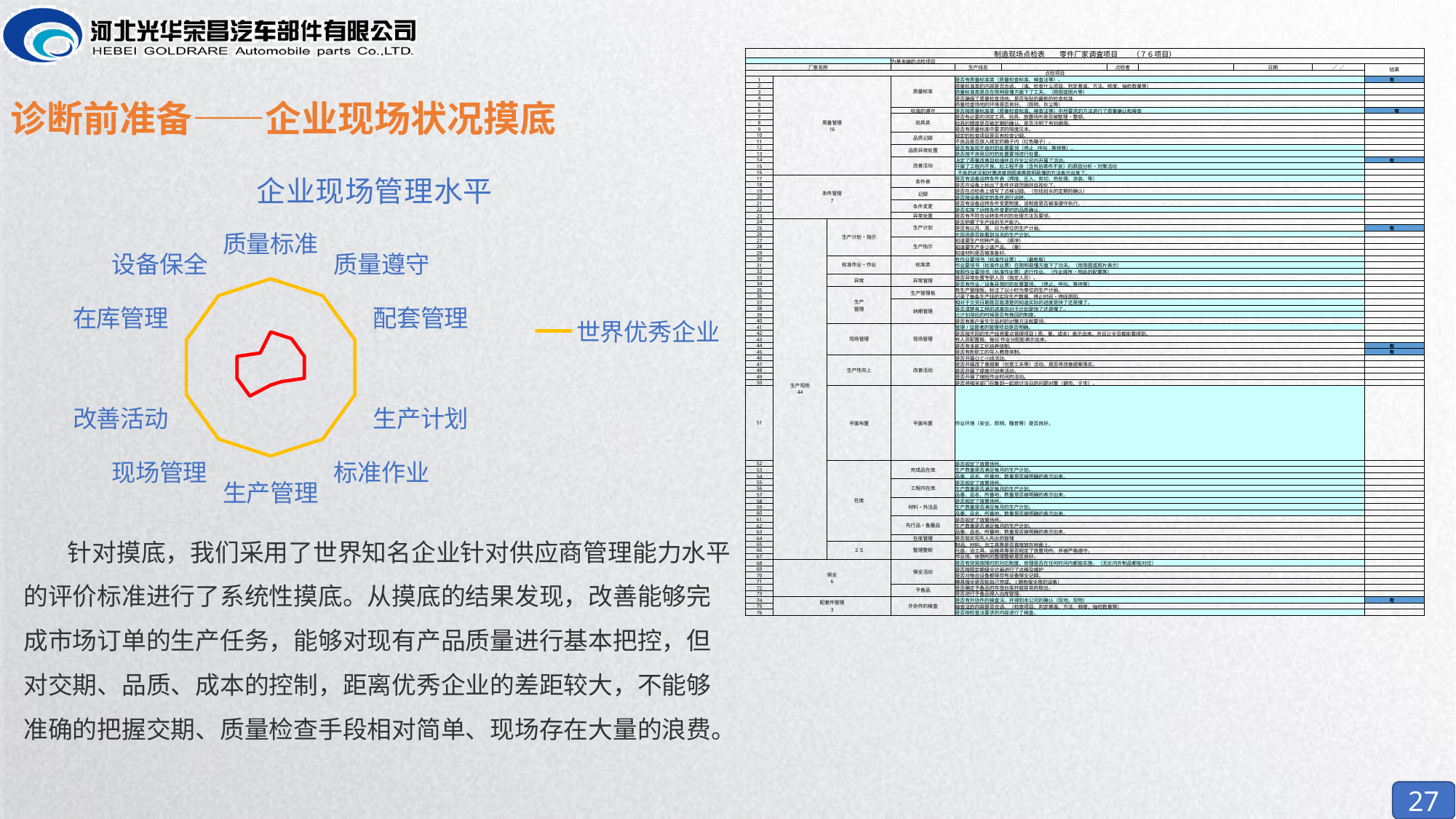
How many series does the legend of the radar chart list? 1 What is the name of the series listed in the legend of the radar chart? 世界优秀企业 How many categories (axes) does the radar chart have? 10 What kind of chart is shown on the left side of the slide? radar chart In the radar chart, which line encloses the larger area, the yellow line or the red line? the yellow line What is the title of the radar chart? 企业现场管理水平 In the radar chart, is the red line inside or outside the yellow 世界优秀企业 line? inside